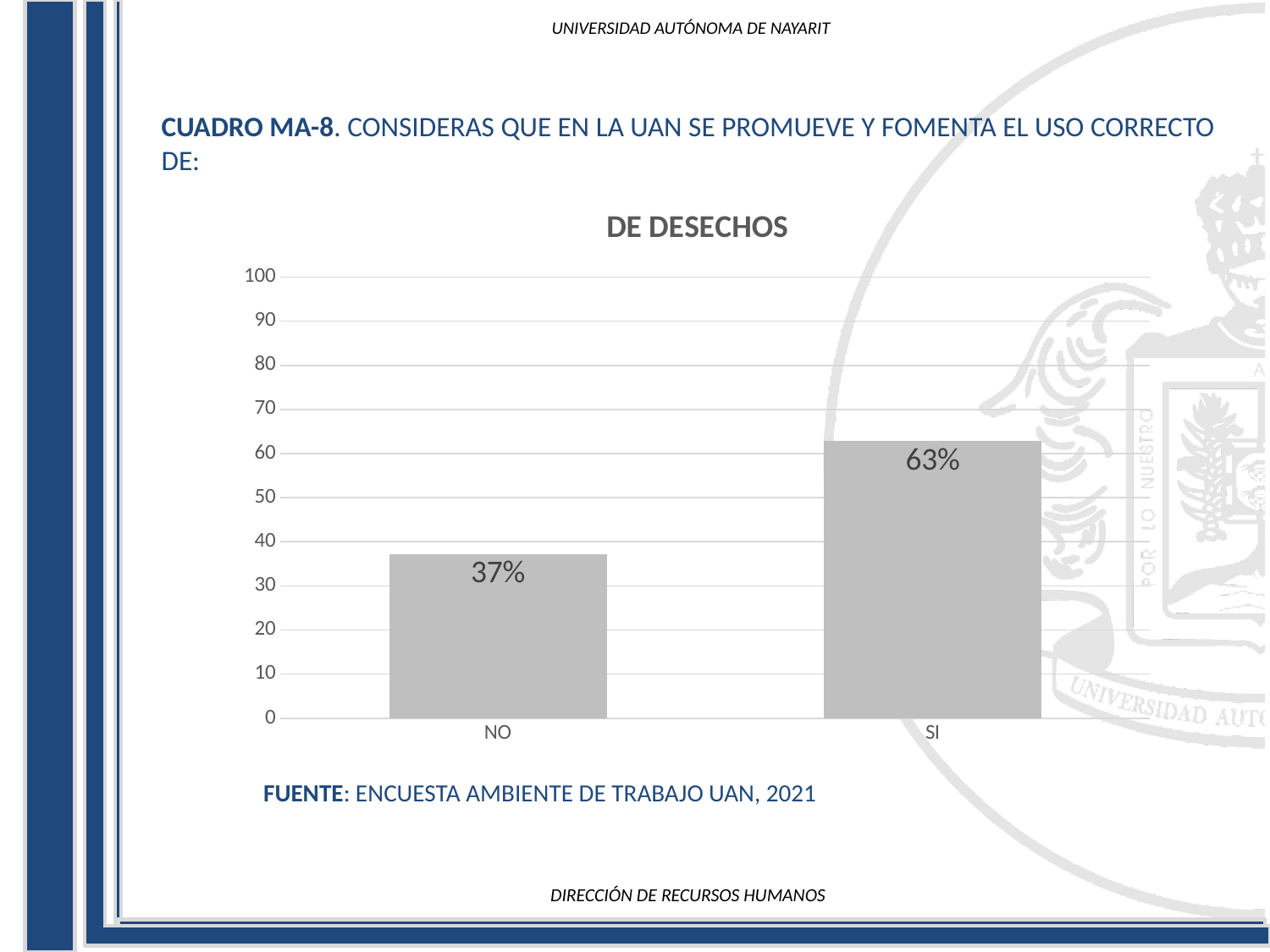
Which category has the lowest value? NO Which category has the highest value? SI What is the value for NO? 37% What is the title of the chart? DE DESECHOS Is the value for NO greater or less than 40? less What is the maximum value shown on the y axis? 100 Is the value for SI greater or less than 50? greater How many categories are shown on the x axis? 2 What is the difference between the values for SI and NO? 26% What is the value for SI? 63% Which is larger, the value for NO or the value for SI? SI What kind of chart is shown on the slide? bar chart